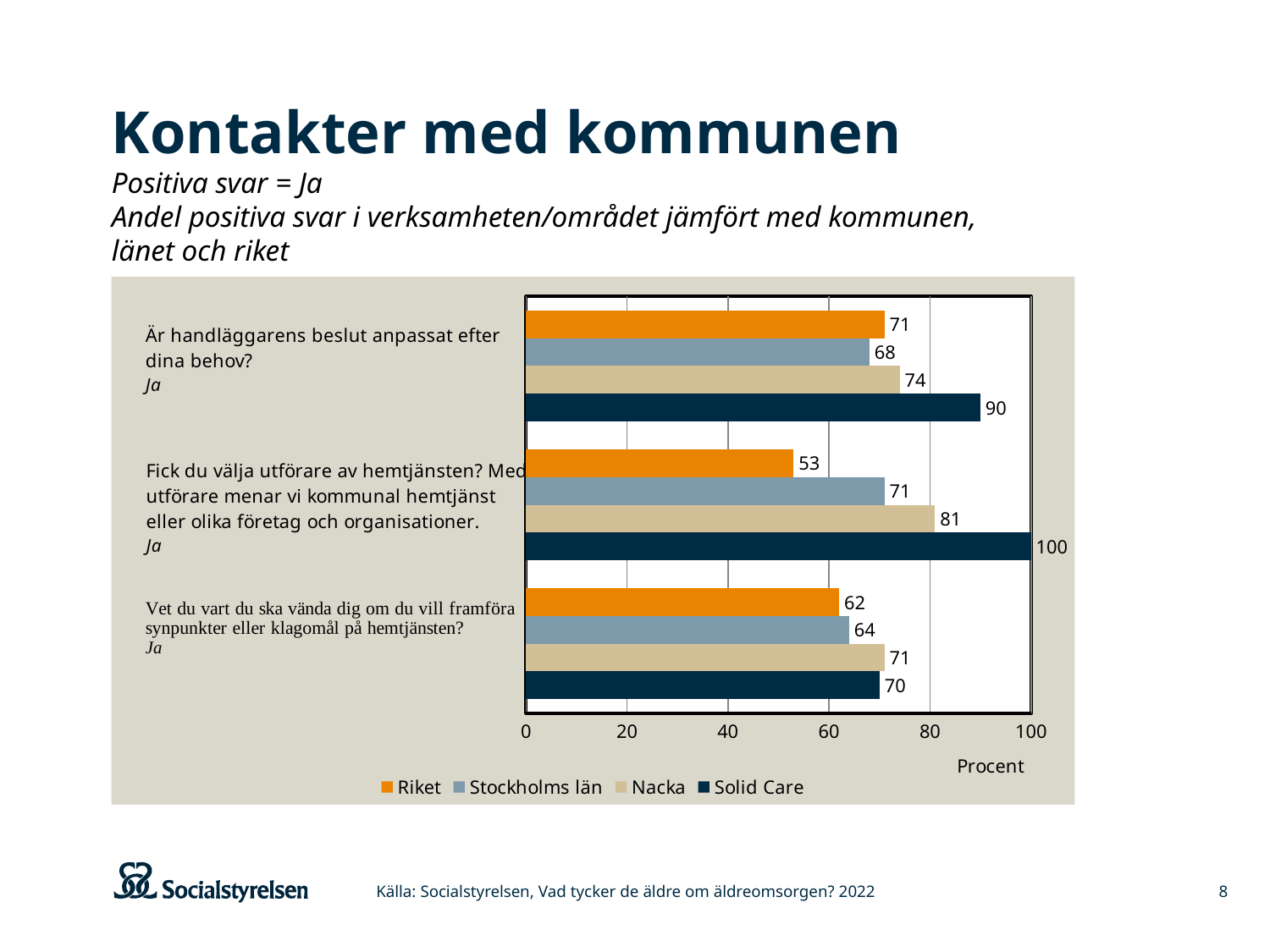
What is the value for Riket on the question "Fick du välja utförare av hemtjänsten?"? 53 What kind of chart is shown on the slide? Bar chart What is the difference between Nacka and Stockholms län on the question "Är handläggarens beslut anpassat efter dina behov?"? 6 What is the value for Solid Care on the question "Är handläggarens beslut anpassat efter dina behov?"? 90 What is the label of the x axis? Procent What is the difference between Solid Care and Riket on the question "Fick du välja utförare av hemtjänsten?"? 47 Which is larger on the question "Vet du vart du ska vända dig om du vill framföra synpunkter eller klagomål på hemtjänsten?": Nacka or Solid Care? Nacka How many questions (categories) are shown on the chart? 3 Which series has the lowest value on the question "Är handläggarens beslut anpassat efter dina behov?"? Stockholms län What is the value for Nacka on the question "Vet du vart du ska vända dig om du vill framföra synpunkter eller klagomål på hemtjänsten?"? 71 Which series has the highest value on the question "Fick du välja utförare av hemtjänsten?"? Solid Care How many series does the legend list? 4